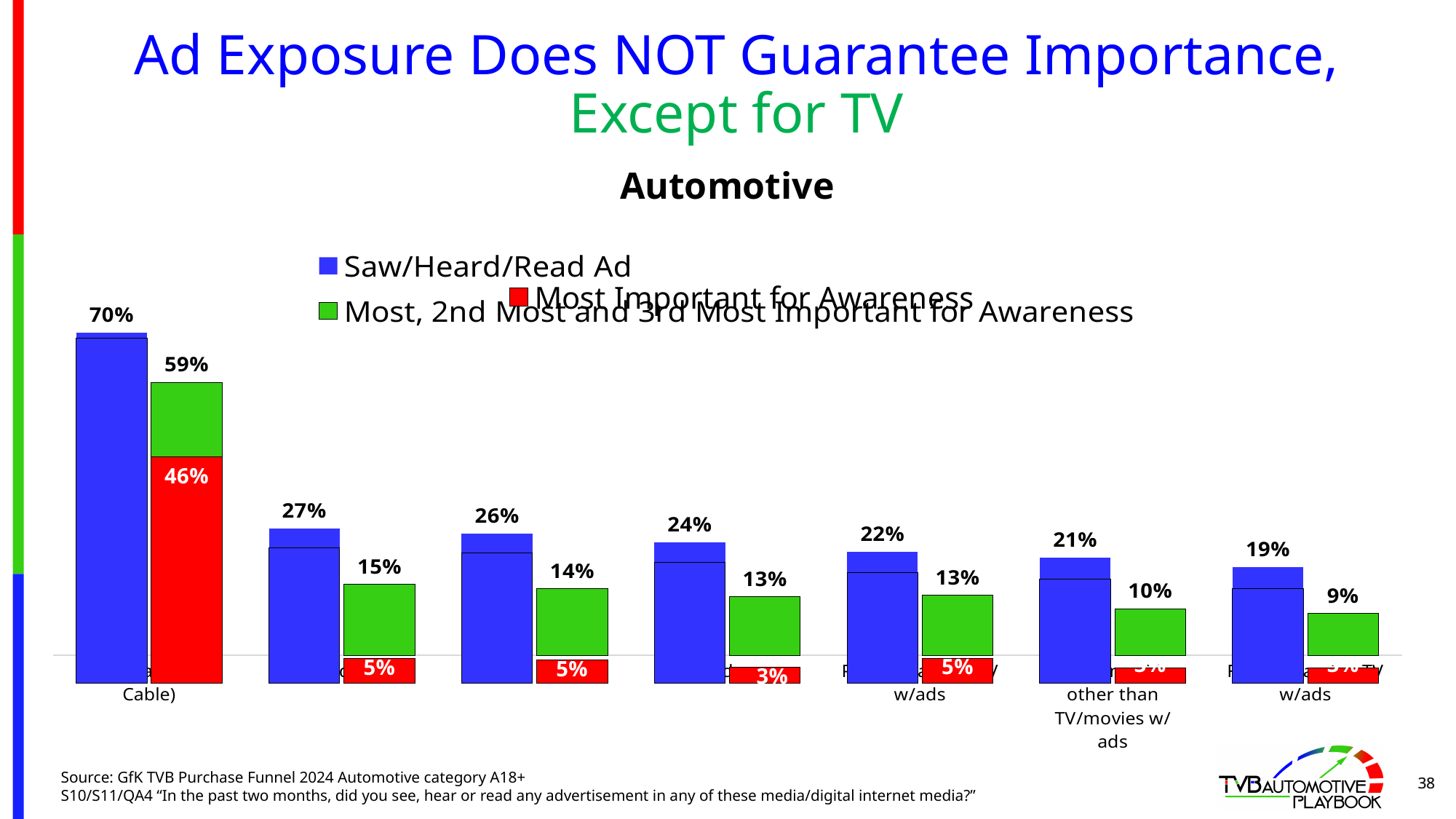
What is the highest Saw/Heard/Read Ad value shown in the chart? 70% What kind of chart is shown on the slide? bar chart What is the Saw/Heard/Read Ad value for the leftmost category? 70% What is the Most, 2nd Most and 3rd Most Important for Awareness value for the leftmost category? 59% Which colour represents the Saw/Heard/Read Ad series in the chart? blue How many categories (groups of bars) are plotted in the chart? 7 What is the lowest Most, 2nd Most and 3rd Most Important for Awareness value shown in the chart? 9% Do the Saw/Heard/Read Ad values rise or fall moving from left to right across the chart? fall What is the Most Important for Awareness value for the leftmost category? 46% For the leftmost category, what is the difference between the Saw/Heard/Read Ad value and the Most, 2nd Most and 3rd Most Important for Awareness value? 11 percentage points How many series does the chart's legend list? 3 What is the Saw/Heard/Read Ad value for the rightmost category? 19%